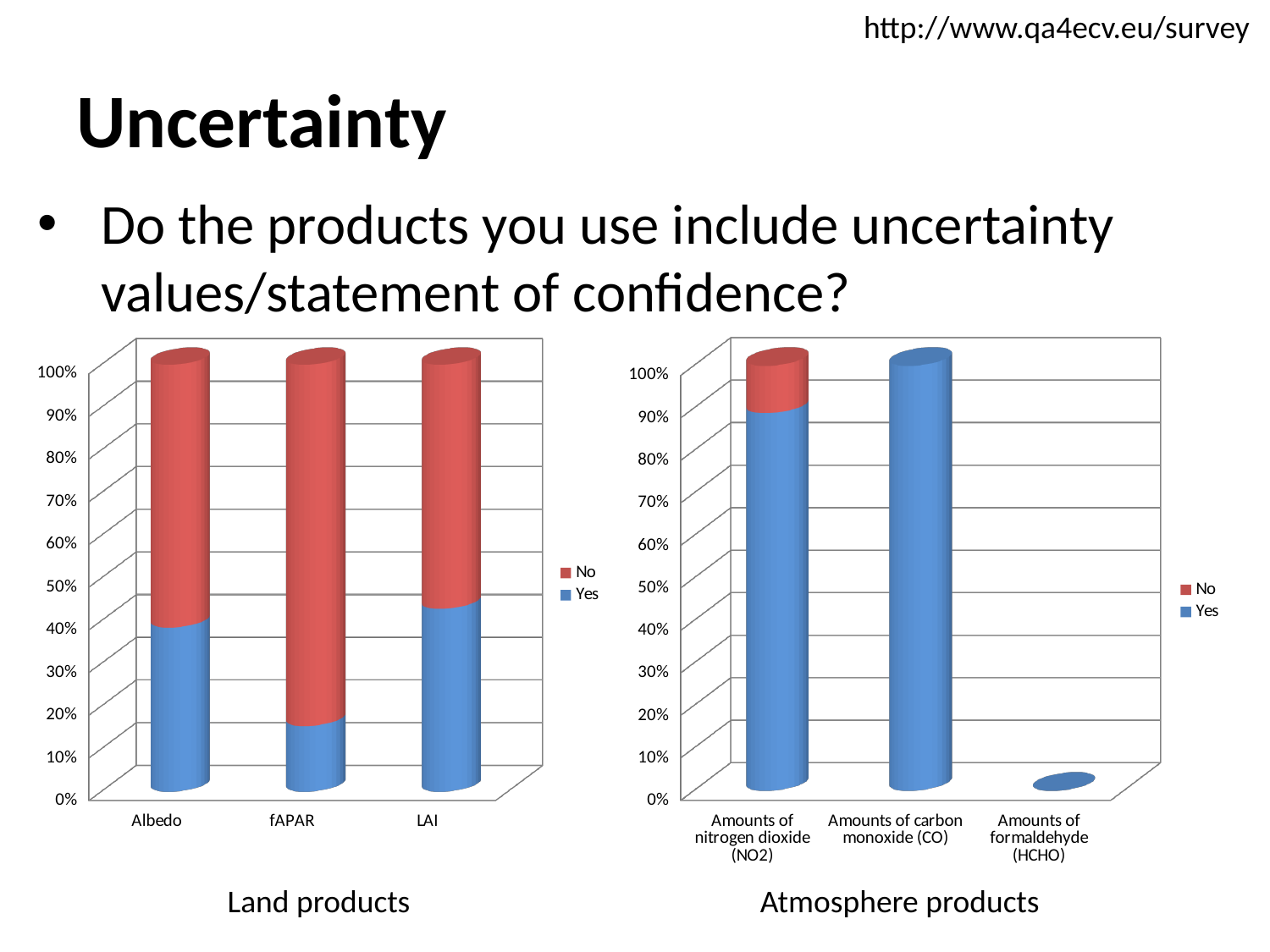
On the Land products chart, is the Yes value for Albedo greater or less than 50%? less On the Atmosphere products chart, how many series does the legend list? 2 On the Land products chart, is the No value for LAI greater or less than 50%? greater On the Atmosphere products chart, is the Yes value for Amounts of nitrogen dioxide (NO2) greater or less than 80%? greater On the Land products chart, how many product categories are shown on the x axis? 3 What kind of chart is the Land products chart? Stacked bar chart On the Land products chart, which product has the lowest Yes share? fAPAR On the Land products chart, which has the larger Yes share, Albedo or fAPAR? Albedo On the Atmosphere products chart, which colour represents the No series? Red On the Atmosphere products chart, which product has the highest Yes share? Amounts of carbon monoxide (CO)